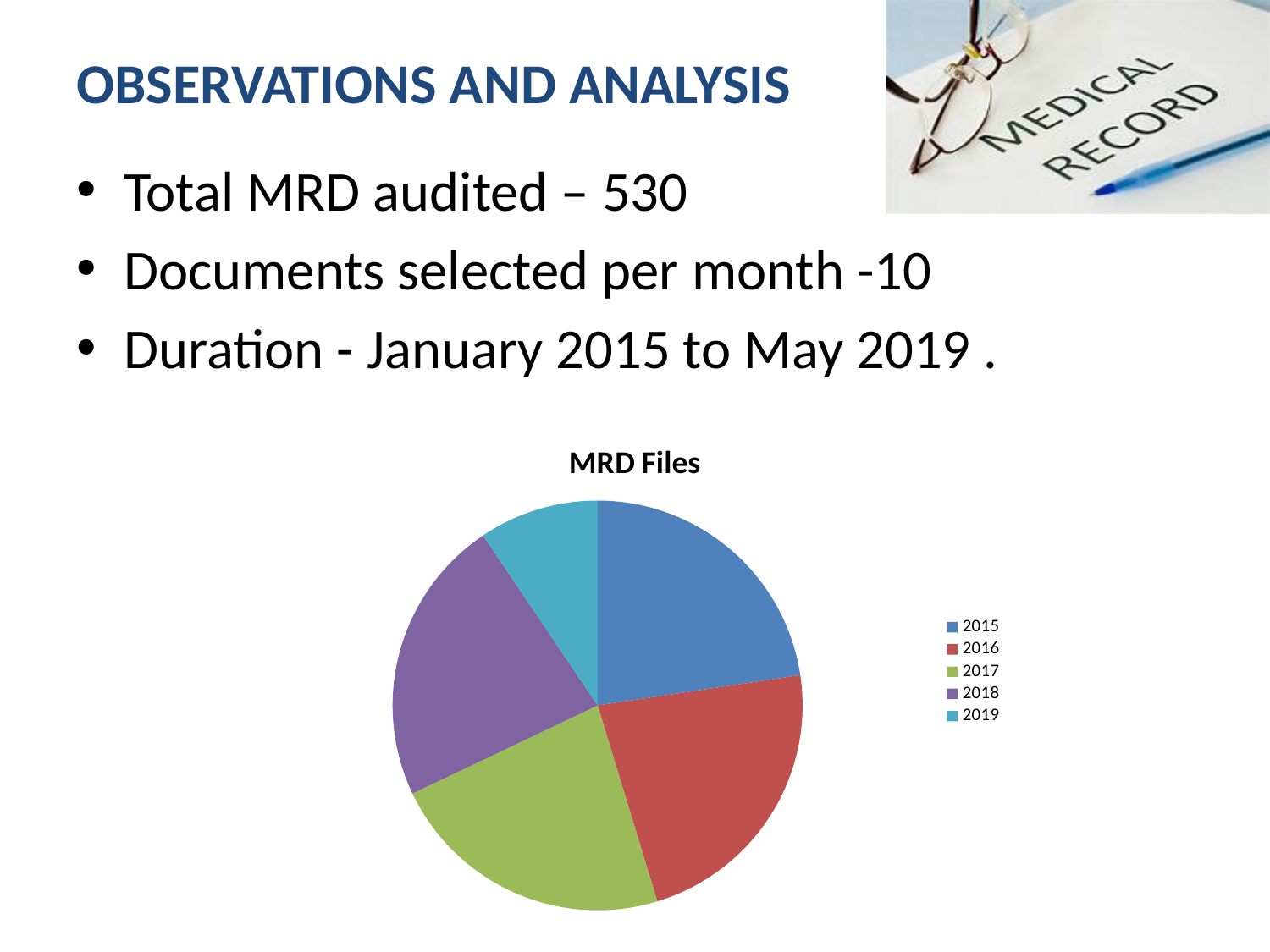
Which slice is larger, 2019 or 2018? 2018 Which year is the first entry listed in the legend? 2015 Which slice is larger, 2017 or 2019? 2017 Which year has the smallest slice in the pie chart? 2019 What is the title of the chart? MRD Files How many entries does the chart's legend list? 5 What kind of chart is shown on the slide? pie chart Which slice is larger, 2015 or 2019? 2015 How many slices does the pie chart have? 5